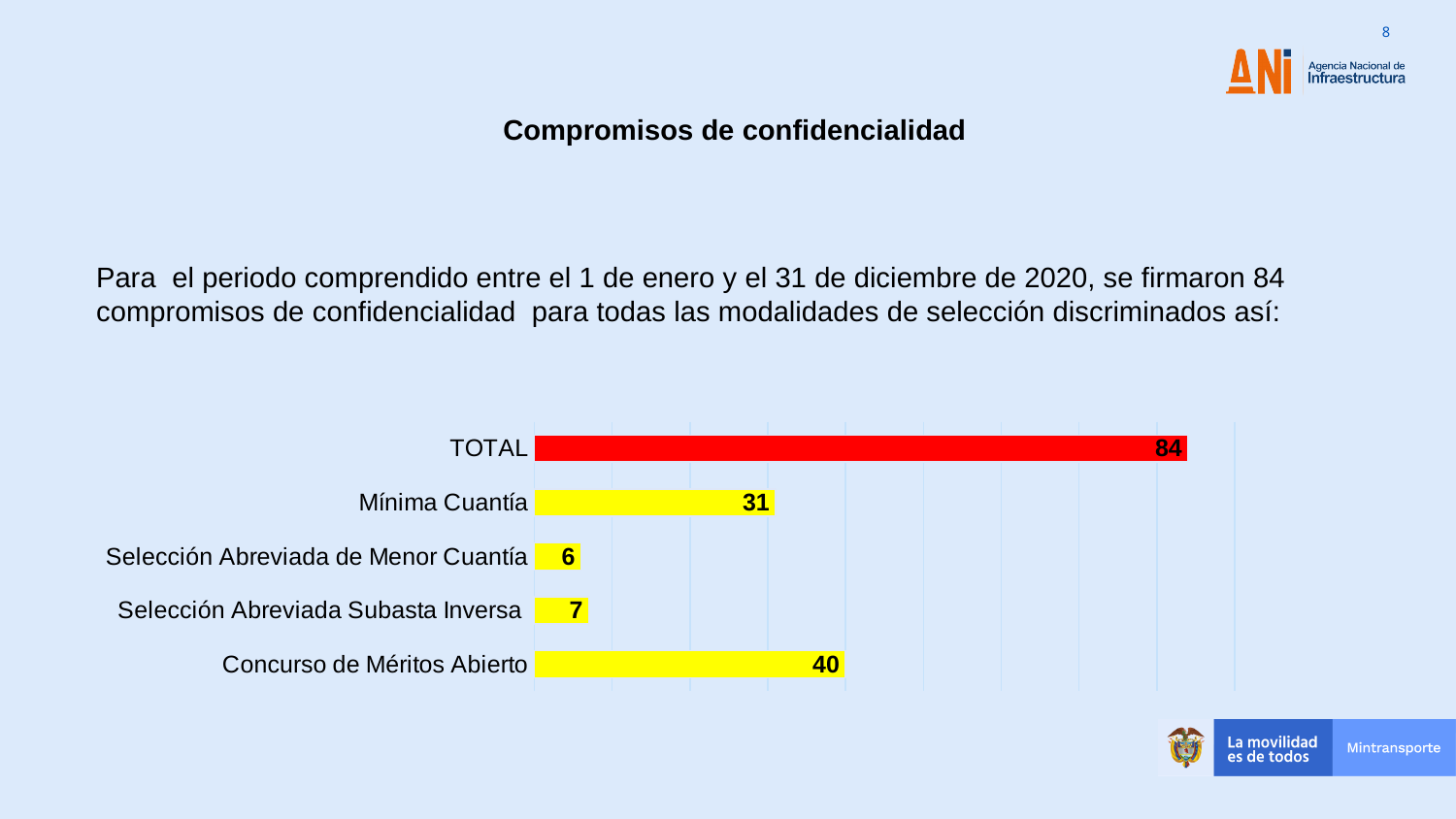
What is the value for Selección Abreviada Subasta Inversa? 7 Which is larger, the value for Mínima Cuantía or the value for Concurso de Méritos Abierto? Concurso de Méritos Abierto What colour is the TOTAL bar? Red What is the value for Mínima Cuantía? 31 What is the difference between the values for Concurso de Méritos Abierto and Mínima Cuantía? 9 How many bars are shown in the chart, including TOTAL? 5 What is the value for Concurso de Méritos Abierto? 40 What is the value for Selección Abreviada de Menor Cuantía? 6 Excluding the TOTAL bar, which category has the highest value? Concurso de Méritos Abierto What is the value of the TOTAL bar? 84 What kind of chart is shown on the slide? Bar chart Which category has the lowest value? Selección Abreviada de Menor Cuantía